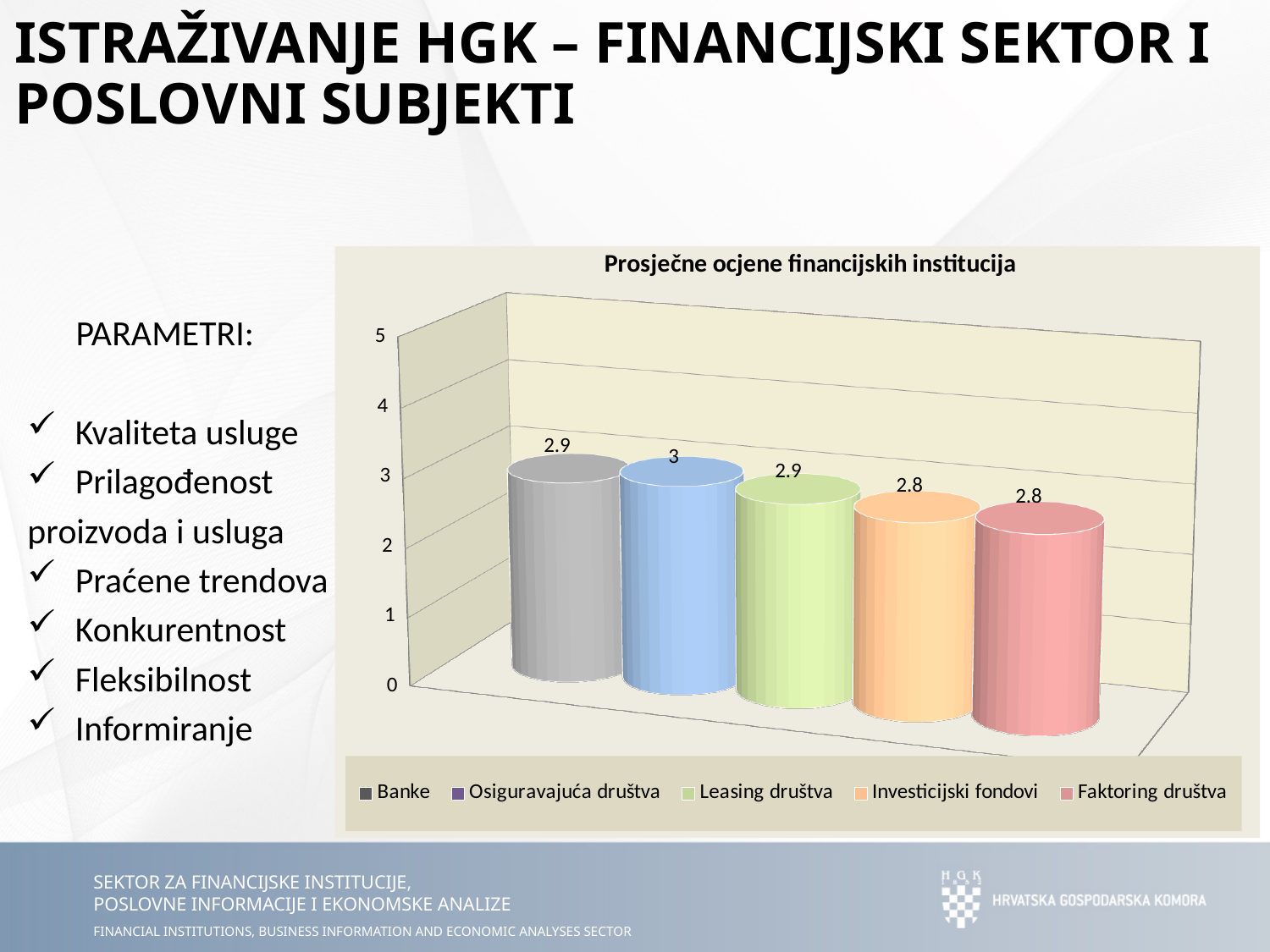
What is the value for Banke? 2.9 What is the value for Leasing društva? 2.9 What is the value for Osiguravajuća društva? 3 What is the difference between the values for Osiguravajuća društva and Faktoring društva? 0.2 Which category has the highest value? Osiguravajuća društva What type of chart is shown on the slide? bar chart Which is larger, the value for Osiguravajuća društva or the value for Investicijski fondovi? Osiguravajuća društva Is the value for Banke greater or less than 4? less What is the title of the chart? Prosječne ocjene financijskih institucija What is the value for Faktoring društva? 2.8 What is the value for Investicijski fondovi? 2.8 How many entries does the legend list? 5